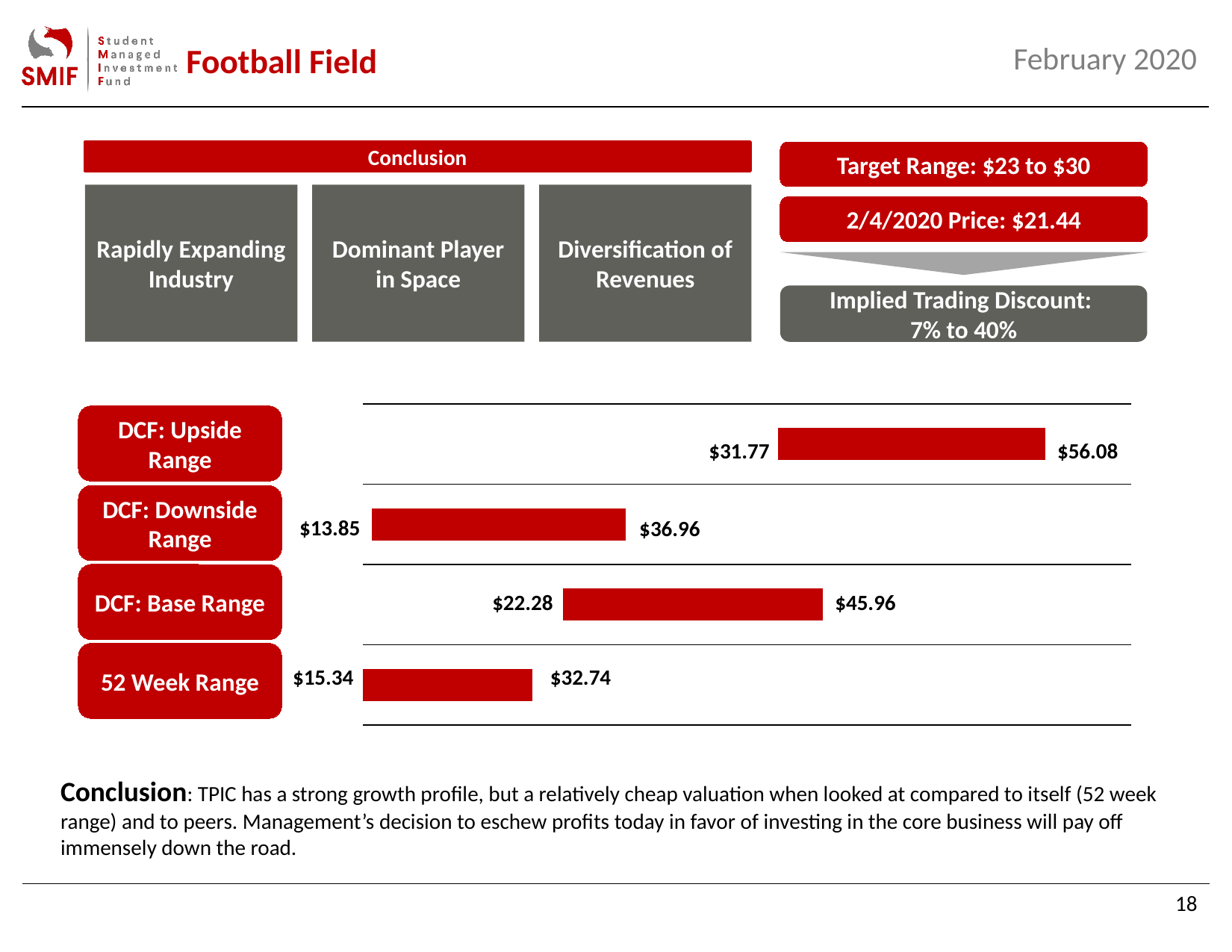
Which is larger, the upper value of the DCF: Base Range or the upper value of the 52 Week Range? DCF: Base Range What is the lower value of the DCF: Downside Range bar? $13.85 Which range has the lowest lower value? DCF: Downside Range What kind of chart is the football field chart? Bar chart What is the upper value of the 52 Week Range bar? $32.74 How many ranges (bars) are shown in the football field chart? 4 What is the difference between the upper and lower values of the 52 Week Range bar? $17.40 What is the upper value of the DCF: Upside Range bar? $56.08 What colour are the bars in the football field chart? Red Which range has the highest upper value? DCF: Upside Range What is the difference between the upper value of the DCF: Base Range and the upper value of the DCF: Downside Range? $9.00 What is the lower value of the DCF: Base Range bar? $22.28